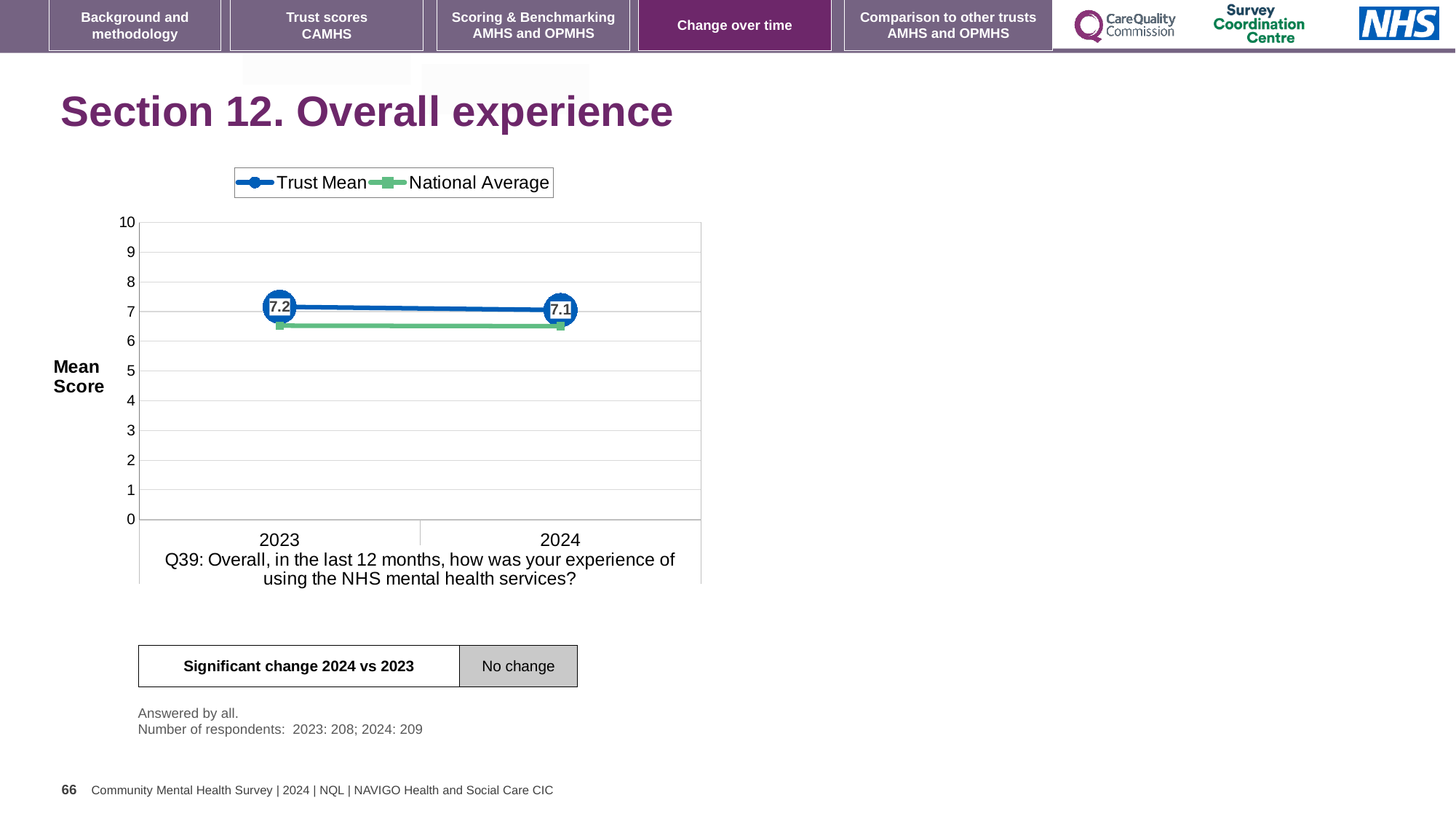
What is the label on the y axis of the chart? Mean Score Is the National Average value for 2023 greater or less than 7? less How many years are shown on the x axis of the chart? 2 Does the Trust Mean score rise or fall from 2023 to 2024? Fall In 2024, which series is higher, Trust Mean or National Average? Trust Mean Which year has the higher Trust Mean score, 2023 or 2024? 2023 How many series does the chart legend list? 2 Is the National Average value for 2024 greater or less than 6? greater What is the Trust Mean score for 2023? 7.2 What type of chart is shown on the slide? Line chart By how much did the Trust Mean score change from 2023 to 2024? 0.1 What is the Trust Mean score for 2024? 7.1